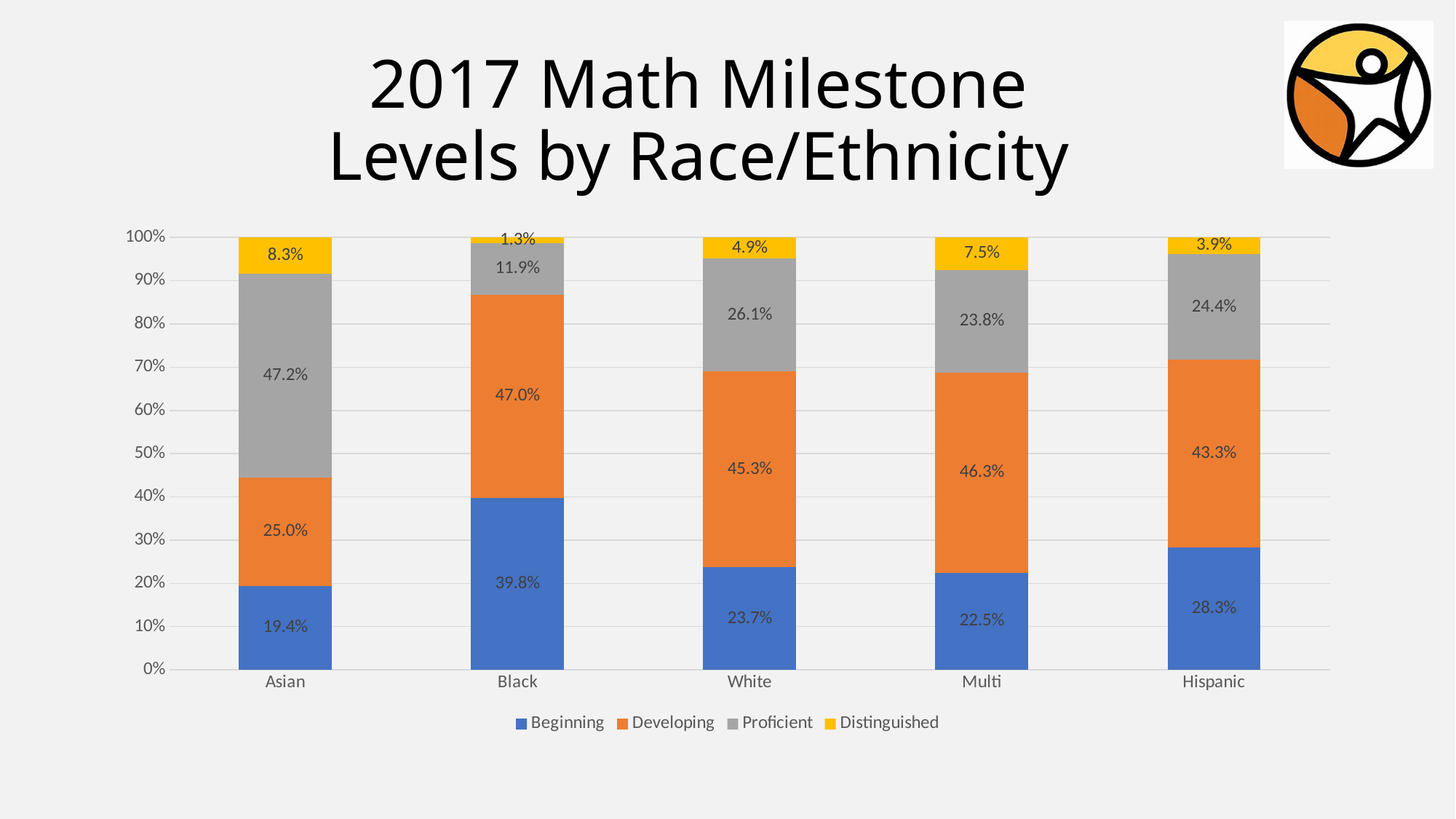
Which race/ethnicity has the highest Beginning value? Black What is the Beginning value for Black? 39.8% How many series does the legend list? 4 What is the Proficient value for Asian? 47.2% What is the Distinguished value for Hispanic? 3.9% What kind of chart is shown on the slide? Stacked bar chart Which is larger, the Developing value for Black or for Hispanic? Black Which colour represents the Distinguished series? Yellow How many race/ethnicity categories are shown on the x axis? 5 Which race/ethnicity has the lowest Distinguished value? Black What is the Developing value for Multi? 46.3% What is the difference between the Proficient values for White and Multi? 2.3%